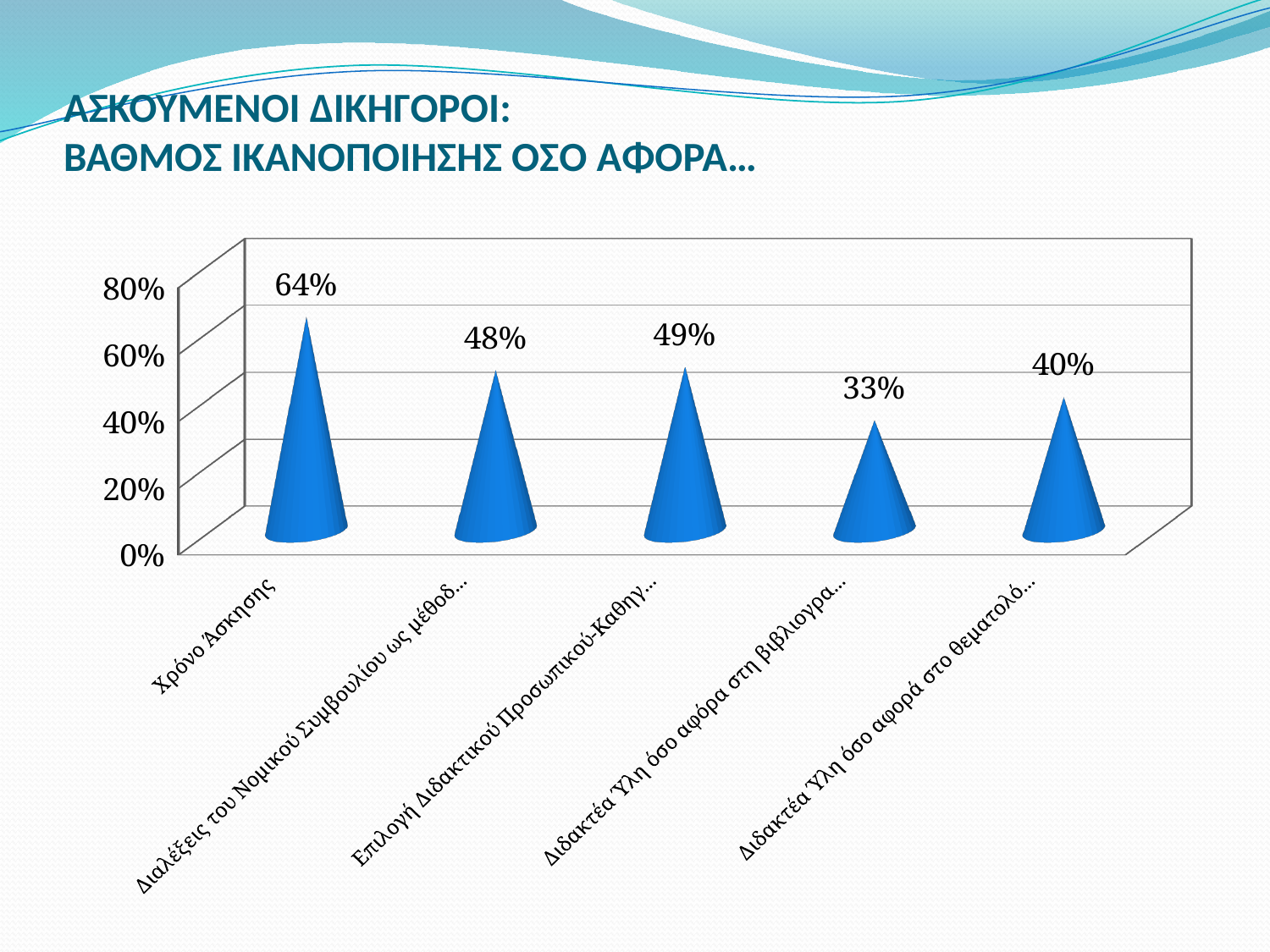
What is the value for Επιλογή Διδακτικού Προσωπικού-Καθηγ...? 49% Which is larger: the value for Χρόνο Άσκησης or the value for Διδακτέα Ύλη όσο αφορά στο θεματολό...? Χρόνο Άσκησης Is the value for Διδακτέα Ύλη όσο αφορά στη βιβλιογρα... greater or less than 40%? less Which category has the lowest value? Διδακτέα Ύλη όσο αφορά στη βιβλιογρα... What kind of chart is shown on the slide? bar chart What is the difference between the value for Χρόνο Άσκησης and the value for Διδακτέα Ύλη όσο αφορά στη βιβλιογρα...? 31% Which category has the highest value? Χρόνο Άσκησης What is the value for Χρόνο Άσκησης? 64% What is the value for the category Διαλέξεις του Νομικού Συμβουλίου ως μέθοδ...? 48% How many categories are shown on the chart? 5 What is the value for Διδακτέα Ύλη όσο αφορά στο θεματολό...? 40% What is the value for Διδακτέα Ύλη όσο αφορά στη βιβλιογρα...? 33%